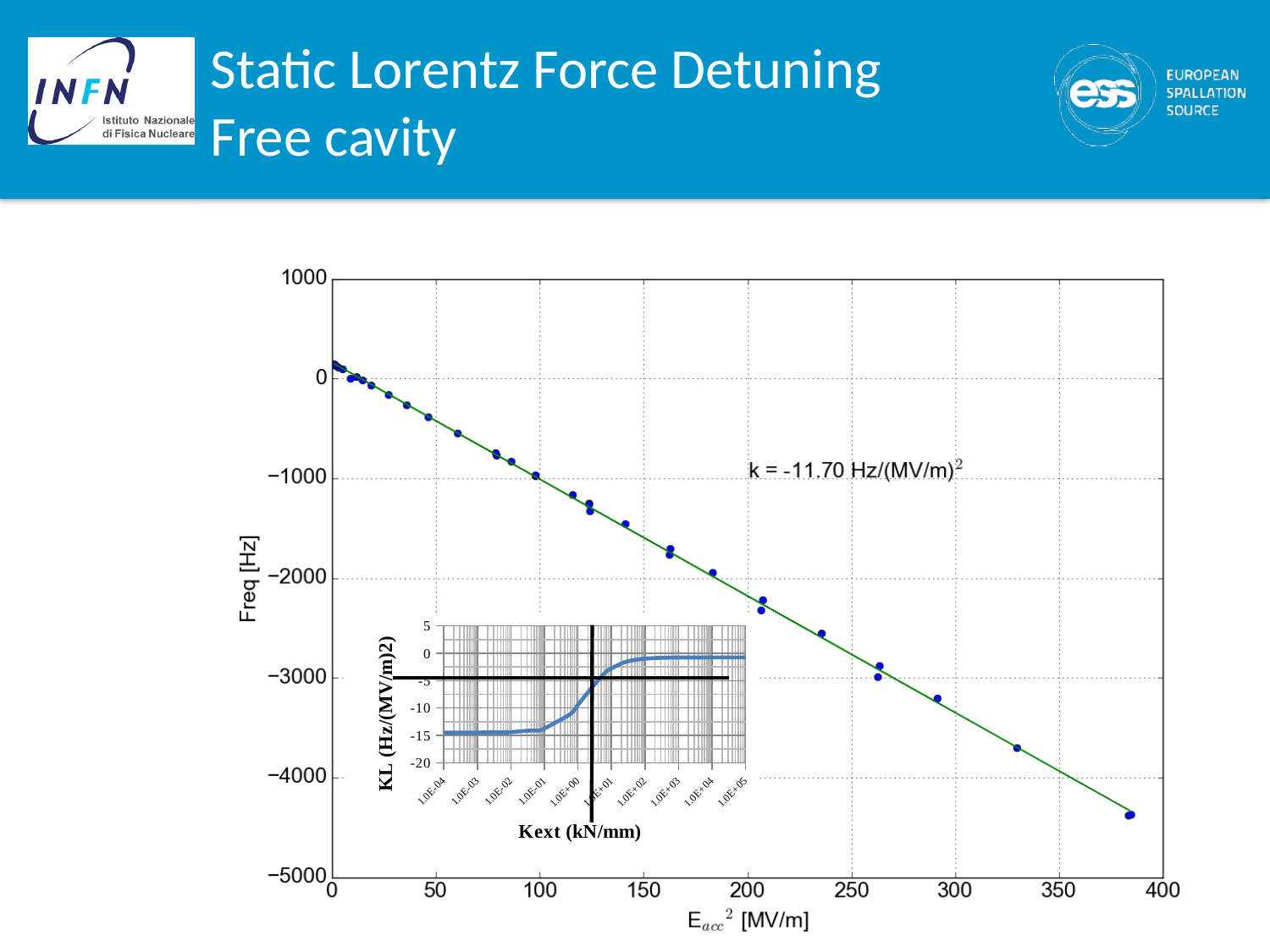
What is the fitted slope k printed on the main chart? -11.70 Hz/(MV/m)^2 In the inset chart, is the KL value at Kext = 1.0E+05 greater or less than -5? greater In the main chart, is the Freq value at E_acc^2 of about 300 greater or less than -3000 Hz? less In the main chart, is the Freq value at E_acc^2 of about 200 greater or less than -2000 Hz? less In the inset chart, does KL rise or fall as Kext increases? rise What is the label of the x axis of the inset chart? Kext (kN/mm) In the main chart, do the Freq values rise or fall as E_acc^2 increases? fall What is the label of the y axis of the main chart? Freq [Hz] What kind of chart is the main chart on the slide? scatter plot with a fitted line